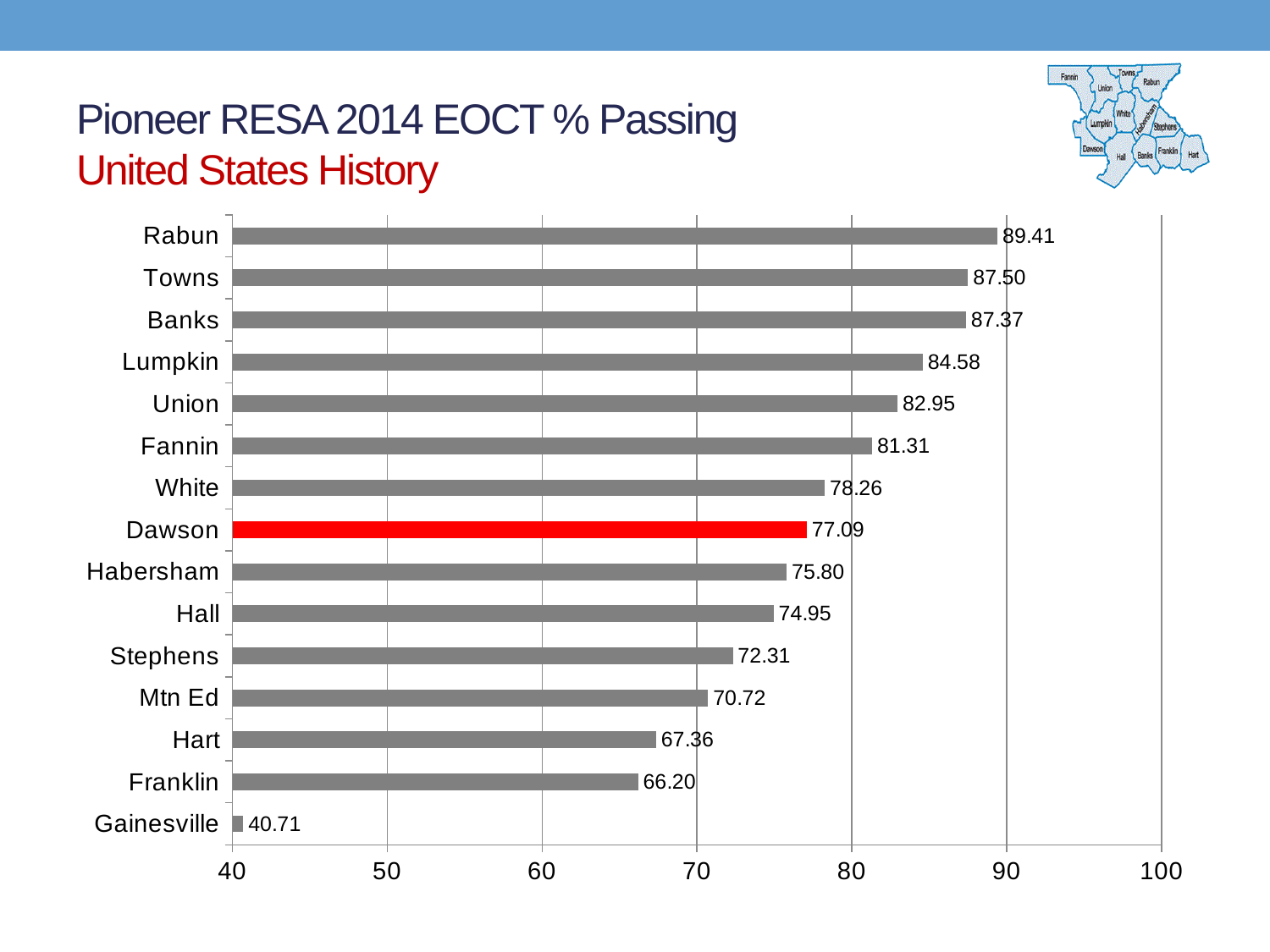
Is the value for Fannin greater or less than 80? greater Which system has the highest % passing? Rabun Which bar is highlighted in red? Dawson What is the % passing value for Lumpkin? 84.58 What is the % passing value for Gainesville? 40.71 How many systems are shown in the chart? 15 What is the difference between the values for Towns and Banks? 0.13 What is the % passing value for Dawson? 77.09 Which system has the lowest % passing? Gainesville What kind of chart is shown on the slide? bar chart What is the difference between the values for Rabun and Dawson? 12.32 Which has a higher % passing, Hall or Stephens? Hall